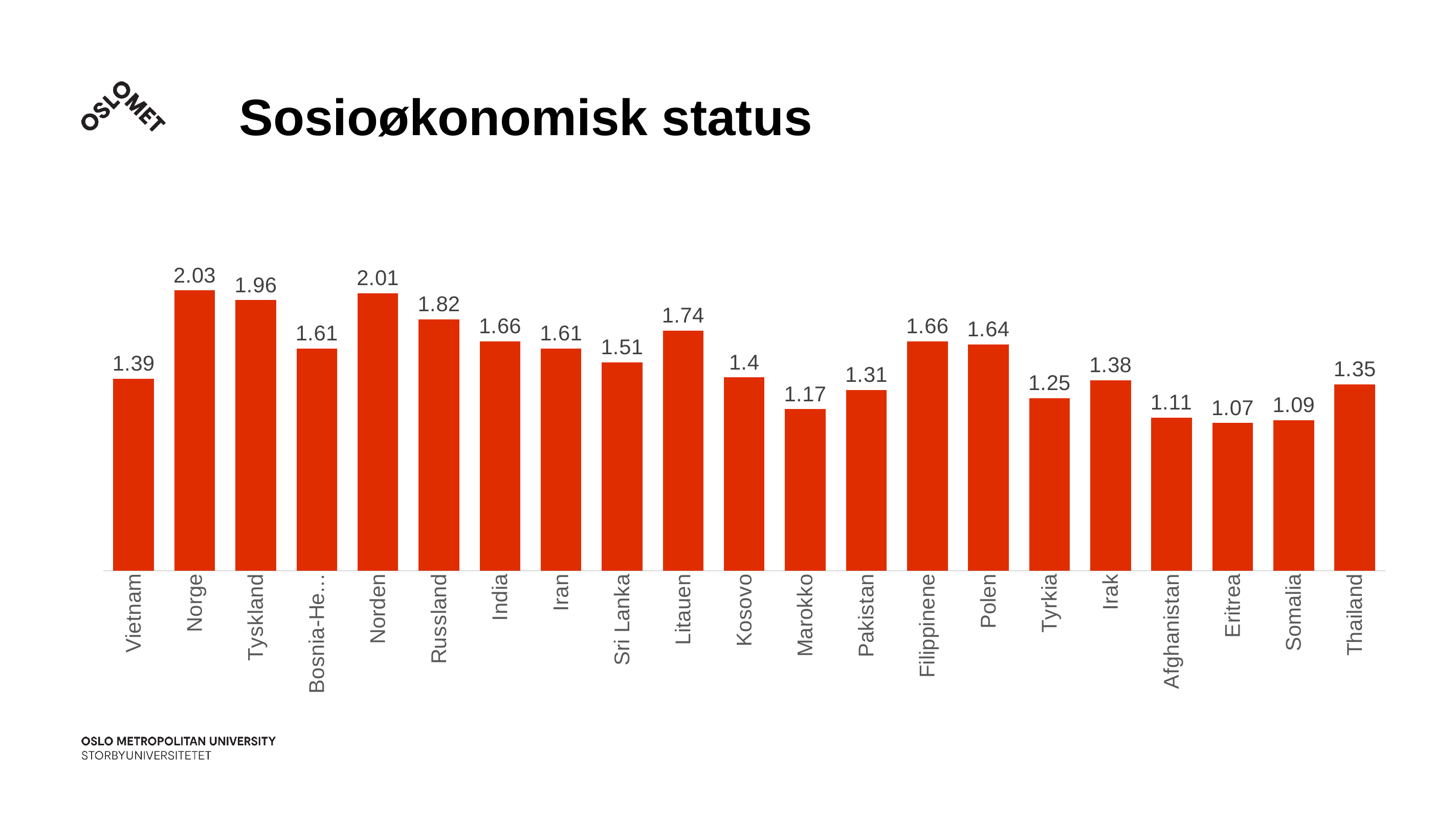
Which category has the highest value? Norge What type of chart is shown on the slide? Bar chart What is the value for Litauen? 1.74 Which category has the lowest value? Eritrea What is the value for Pakistan? 1.31 What is the title of the chart? Sosioøkonomisk status What is the value for Norge? 2.03 What is the value for Thailand? 1.35 What is the difference between the values for Norge and Eritrea? 0.96 What is the difference between the values for Russland and Kosovo? 0.42 Which has a larger value, Tyskland or Russland? Tyskland How many categories are shown in the chart? 21